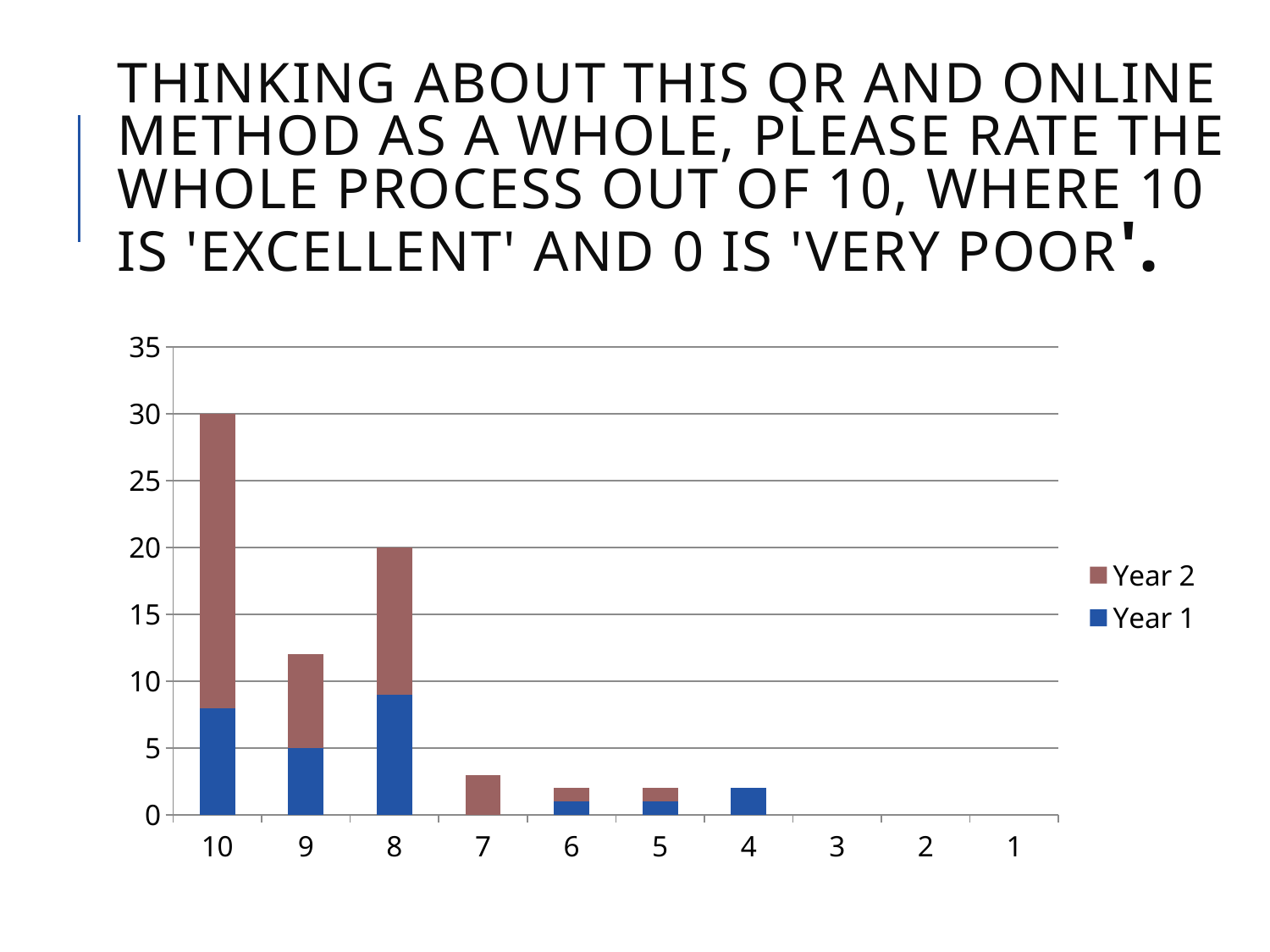
Which rating category has the tallest stacked bar? 10 How many rating categories are shown on the x axis? 10 Is the total for rating 9 greater or less than 10? greater What is the total height of the stacked bar for rating 8? 20 Is the Year 1 value for rating 10 greater or less than 10? less Which has the larger total, rating 10 or rating 8? 10 Do the bar totals generally rise or fall moving from rating 10 to rating 1 along the x axis? fall Which series is shown in blue? Year 1 How many series does the legend list? 2 What is the total height of the stacked bar for rating 10? 30 What is the Year 1 value for rating 9? 5 What kind of chart is shown on the slide? bar chart